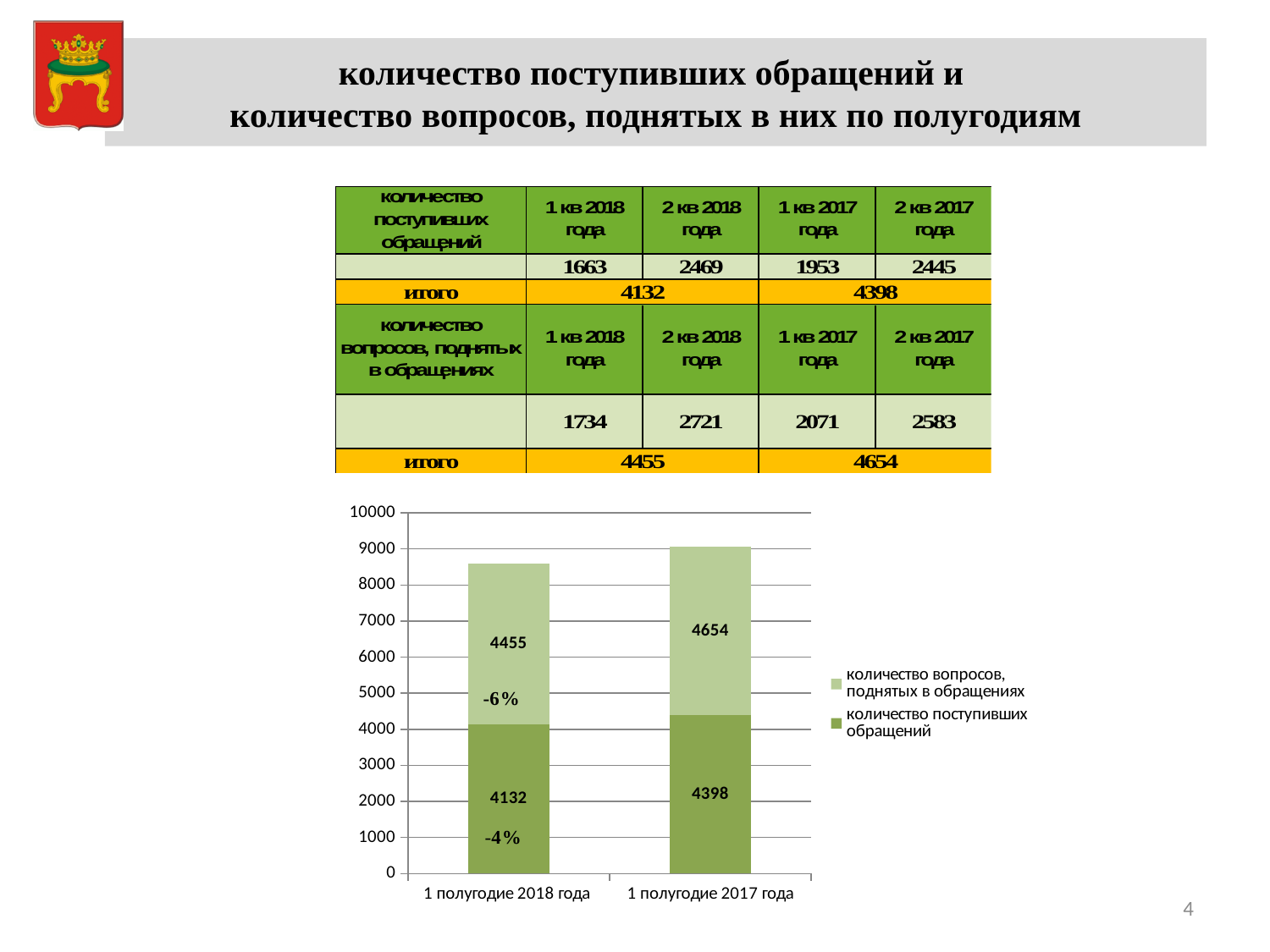
In the chart, what is the value of 'количество поступивших обращений' for '1 полугодие 2018 года'? 4132 What type of chart is shown on the slide? stacked bar chart What is the total of the stacked bar for '1 полугодие 2017 года'? 9052 What percentage change label is shown on the 'количество поступивших обращений' segment for '1 полугодие 2018 года'? -4% What is the total of the stacked bar for '1 полугодие 2018 года'? 8587 Which category has the higher value for 'количество вопросов, поднятых в обращениях': '1 полугодие 2018 года' or '1 полугодие 2017 года'? 1 полугодие 2017 года What is the difference between 'количество поступивших обращений' for '1 полугодие 2017 года' and '1 полугодие 2018 года'? 266 How many series does the chart legend list? 2 In the chart, what is the value of 'количество вопросов, поднятых в обращениях' for '1 полугодие 2017 года'? 4654 In the chart, what is the value of 'количество поступивших обращений' for '1 полугодие 2017 года'? 4398 In the chart, what is the value of 'количество вопросов, поднятых в обращениях' for '1 полугодие 2018 года'? 4455 How many categories are shown on the x axis of the chart? 2